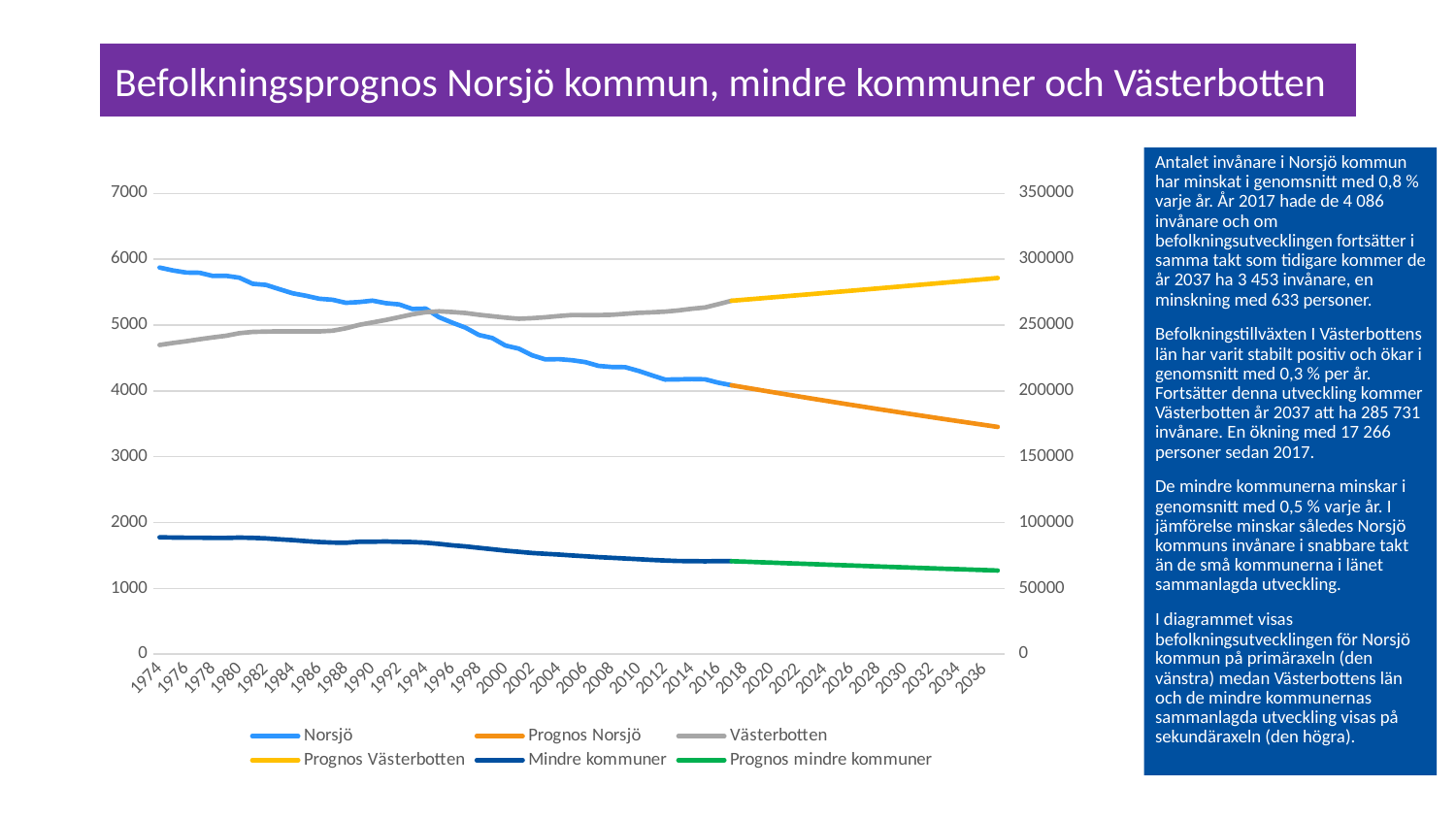
What is the title of the slide's chart? Befolkningsprognos Norsjö kommun, mindre kommuner och Västerbotten Does the Norsjö line rise or fall from 1974 to 2016? Fall What colour is the Prognos Norsjö line in the chart? Orange Does the Mindre kommuner line rise or fall from 1974 to 2016? Fall Does the Prognos Västerbotten line rise or fall from 2018 to 2036? Rise How many series does the chart's legend list? 6 Is the value for Norsjö in 1974 greater or less than 5000 on the left axis? greater Is the value for Norsjö in 2010 greater or less than 5000 on the left axis? less What kind of chart is shown on the slide? Line chart Is the value for Mindre kommuner in 1974 greater or less than 100000 on the right axis? less